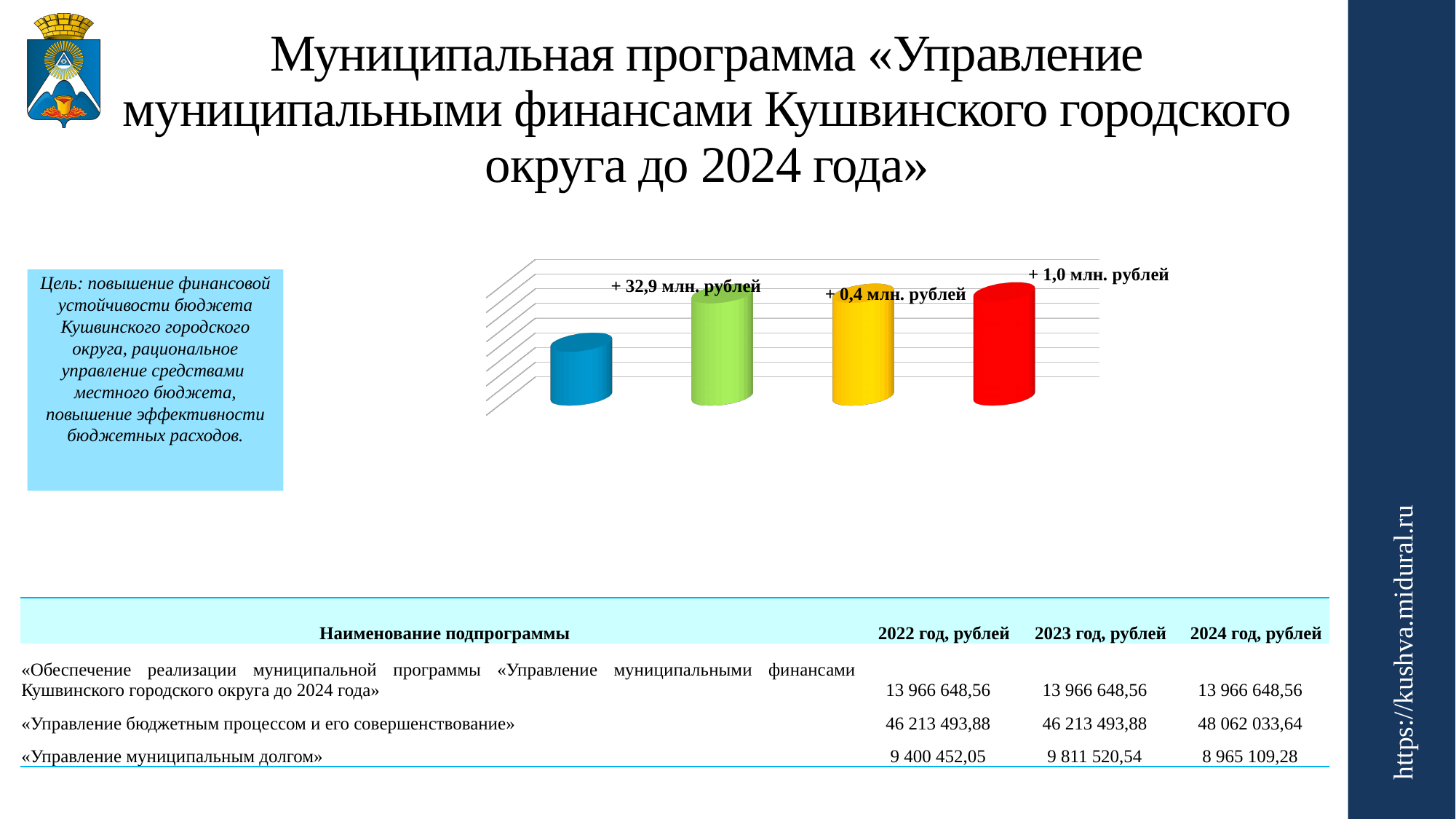
Do the bars generally rise or fall from left to right across the chart? rise What kind of chart is shown on the slide? bar chart How many bars does the chart contain? 4 Which is taller, the blue bar or the green bar? the green bar What increase is annotated above the red bar? + 1,0 млн. рублей What colour is the leftmost bar in the chart? blue Which is taller, the blue bar or the red bar? the red bar What increase is annotated above the yellow bar? + 0,4 млн. рублей How many bars in the chart have an increase annotation above them? 3 Which bar in the chart is the lowest? the blue (leftmost) bar What increase is annotated above the green bar? + 32,9 млн. рублей